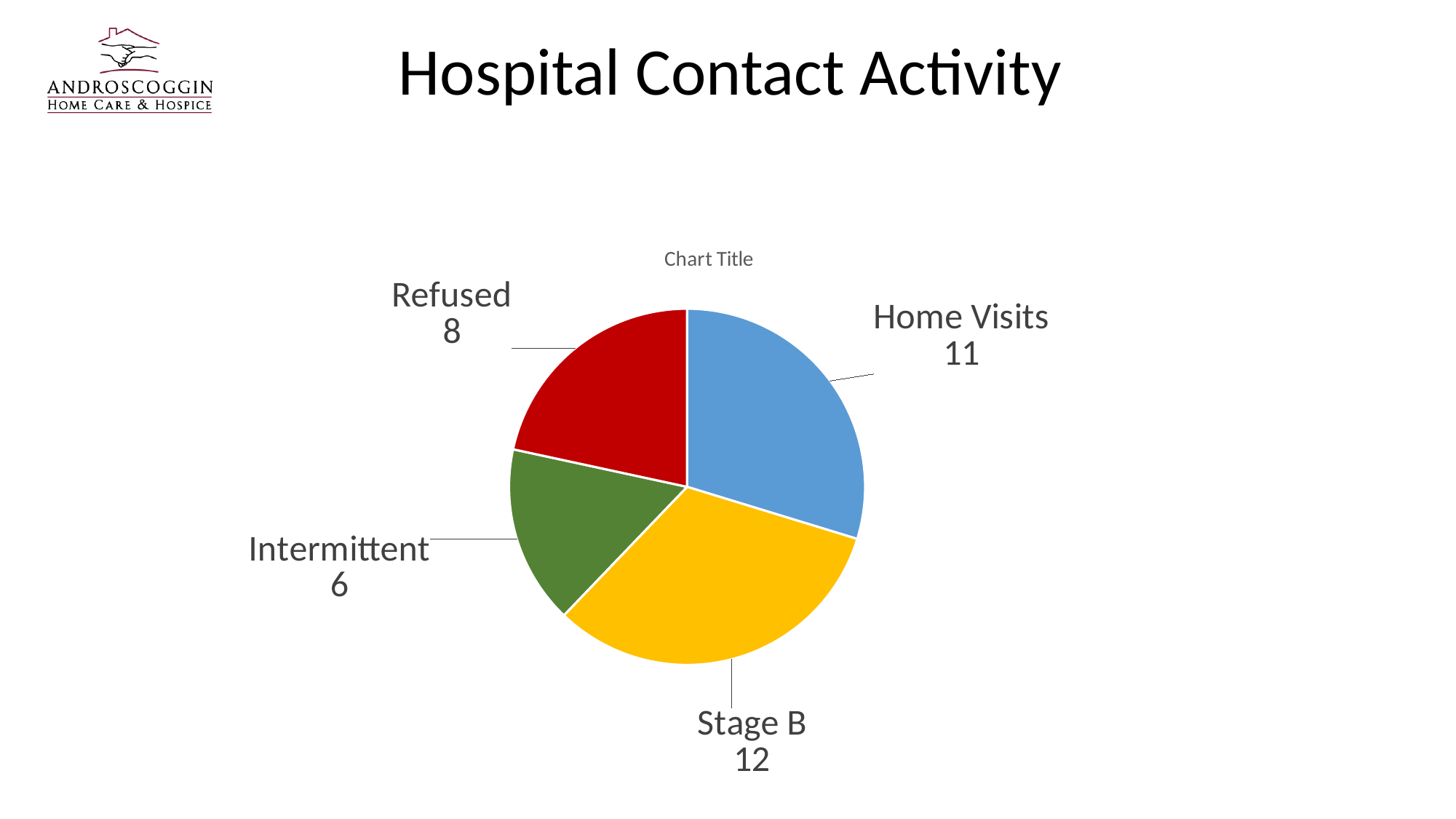
How many categories are shown in the pie chart? 4 What colour is the Stage B slice? yellow Which category has the highest value? Stage B Which is larger, the value for Refused or the value for Intermittent? Refused What kind of chart is shown on the slide? pie chart What is the value for Intermittent? 6 Which category has the lowest value? Intermittent What is the value for Home Visits? 11 What is the value for Stage B? 12 What is the value for Refused? 8 What share of the pie does Home Visits represent, as a percentage rounded to the nearest whole number? 30% What is the difference between the values for Stage B and Intermittent? 6